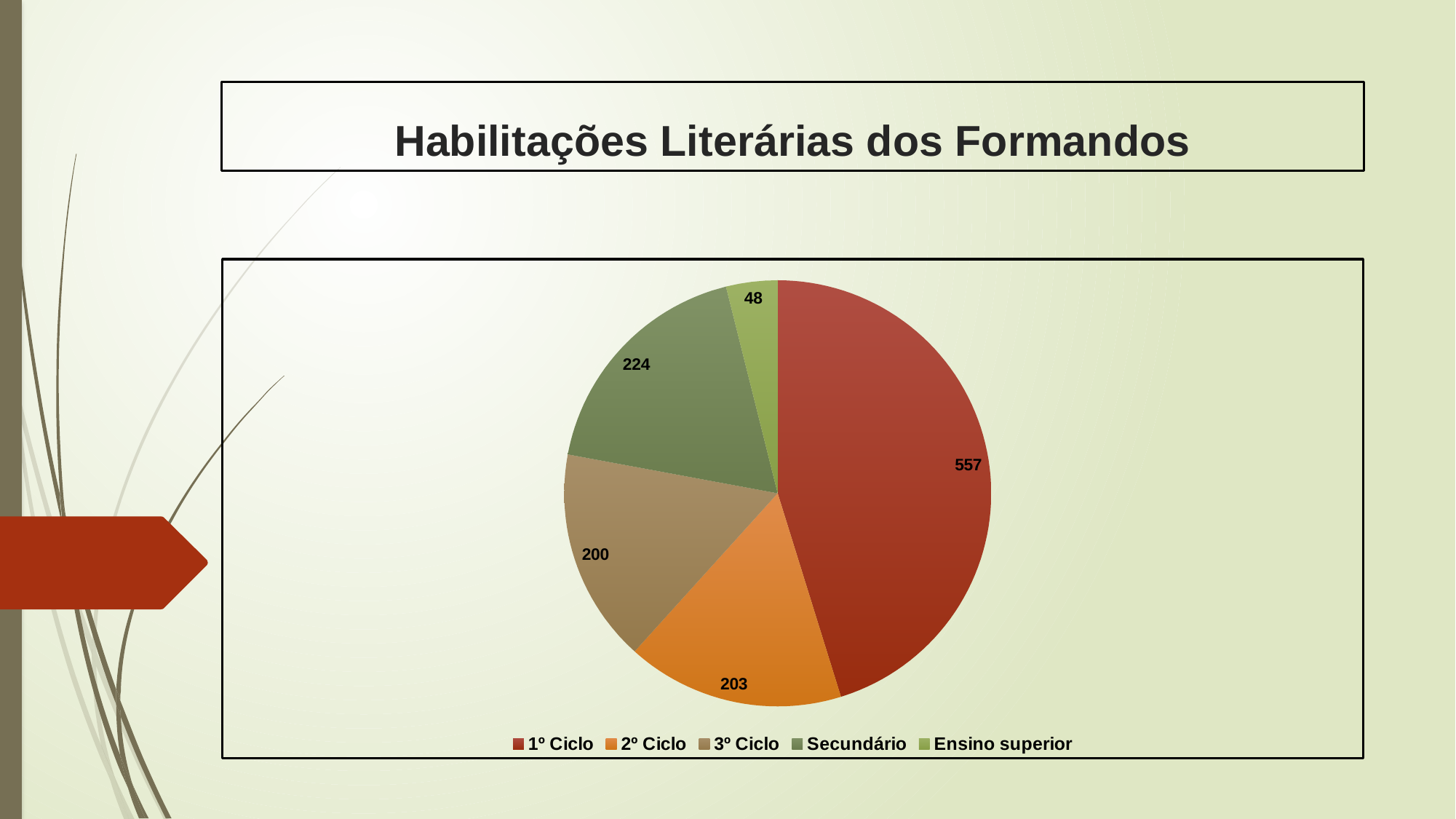
What is the title of the chart? Habilitações Literárias dos Formandos What is the total of all slices in the pie chart? 1232 Which is larger, the value for 2º Ciclo or 3º Ciclo? 2º Ciclo Which category has the largest slice? 1º Ciclo What is the value for Secundário? 224 What is the value for Ensino superior? 48 What is the difference between the values for 1º Ciclo and Secundário? 333 What share of the pie does 1º Ciclo represent, to one decimal place? 45.2% Which category has the smallest slice? Ensino superior What type of chart is shown on the slide? Pie chart What is the value for 1º Ciclo? 557 How many categories does the pie chart have? 5